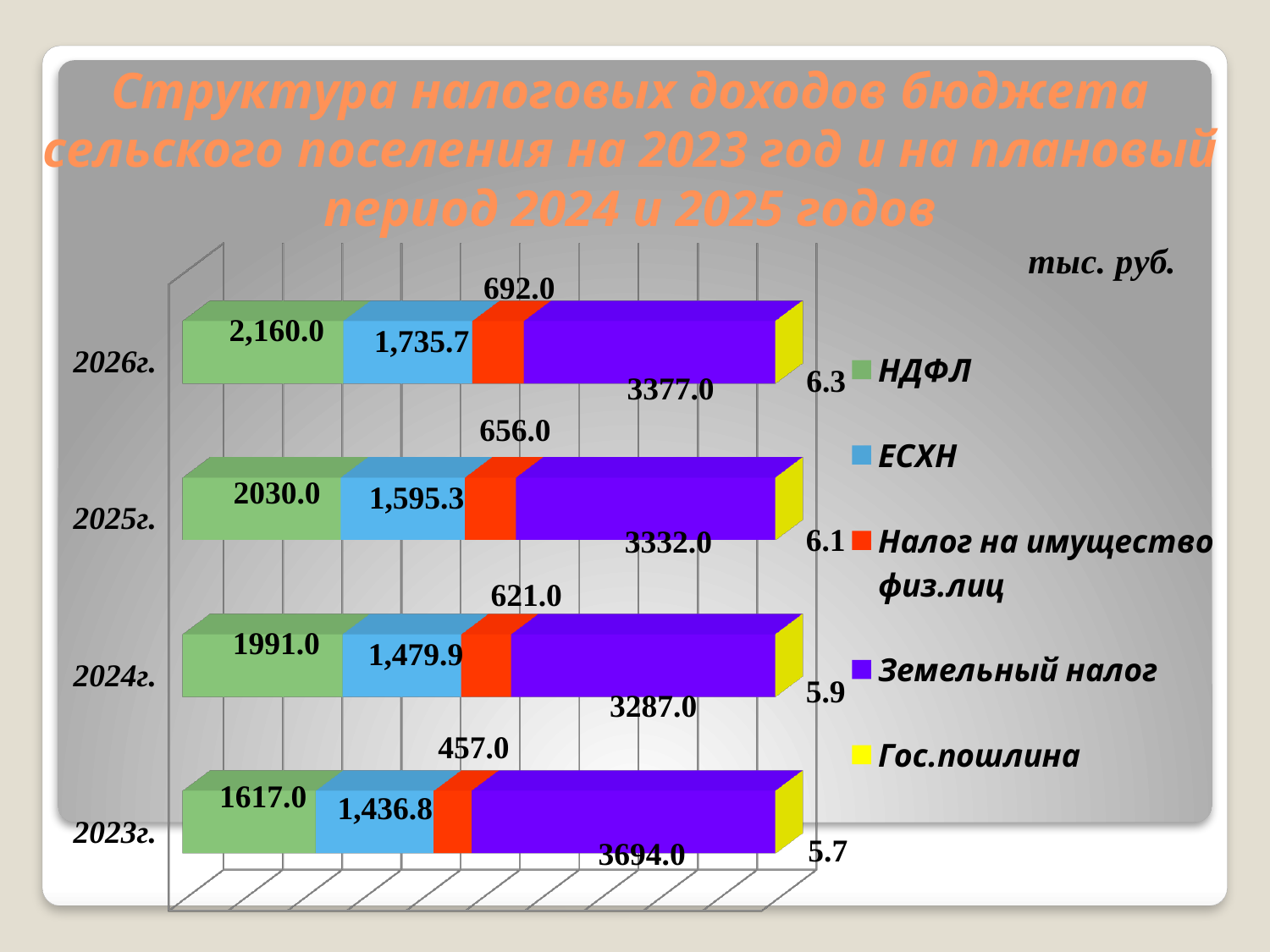
How many series does the legend list? 5 Which is larger: Земельный налог in 2023г. or Земельный налог in 2024г.? Земельный налог in 2023г. What is the difference between НДФЛ in 2026г. and НДФЛ in 2023г.? 543.0 What kind of chart is shown on the slide? Stacked bar chart What is the value of Земельный налог for 2023г.? 3694.0 What is the value of Налог на имущество физ.лиц for 2023г.? 457.0 What is the value of ЕСХН for 2024г.? 1,479.9 How many years (categories) are shown in the chart? 4 What is the value of НДФЛ for 2026г.? 2,160.0 In which year is Земельный налог the highest? 2023г. What is the value of Гос.пошлина for 2025г.? 6.1 In which year is НДФЛ the lowest? 2023г.